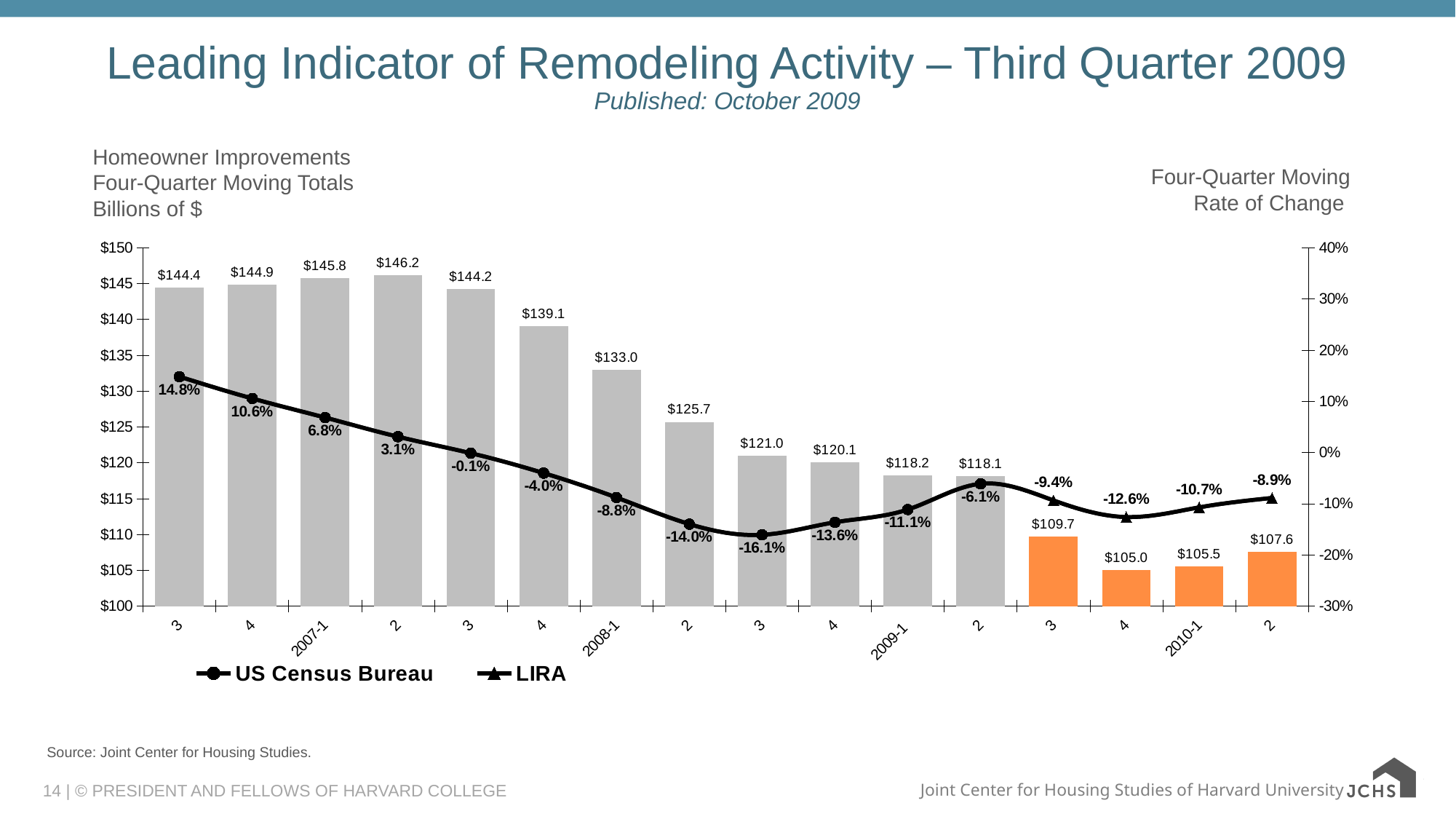
What is the four-quarter moving rate of change shown for the quarter labeled 2009-1? -11.1% What is the lowest four-quarter moving total for homeowner improvements shown on the chart? $105.0 What is the four-quarter moving rate of change shown for the quarter labeled 2008-1? -8.8% What are the two series named in the legend? US Census Bureau and LIRA Which quarter has the highest four-quarter moving total for homeowner improvements? 2 (the quarter after 2007-1), $146.2 What is the four-quarter moving total for homeowner improvements in the quarter labeled 2007-1? $145.8 How many series does the legend list? 2 What is the lowest four-quarter moving rate of change shown on the chart? -16.1% What is the four-quarter moving total for homeowner improvements in the quarter labeled 2010-1? $105.5 How many bars (quarters) are plotted on the chart? 16 Which is larger, the four-quarter moving total for 2009-1 or for 2010-1? 2009-1 What is the difference between the four-quarter moving totals for 2008-1 and 2009-1? $14.8